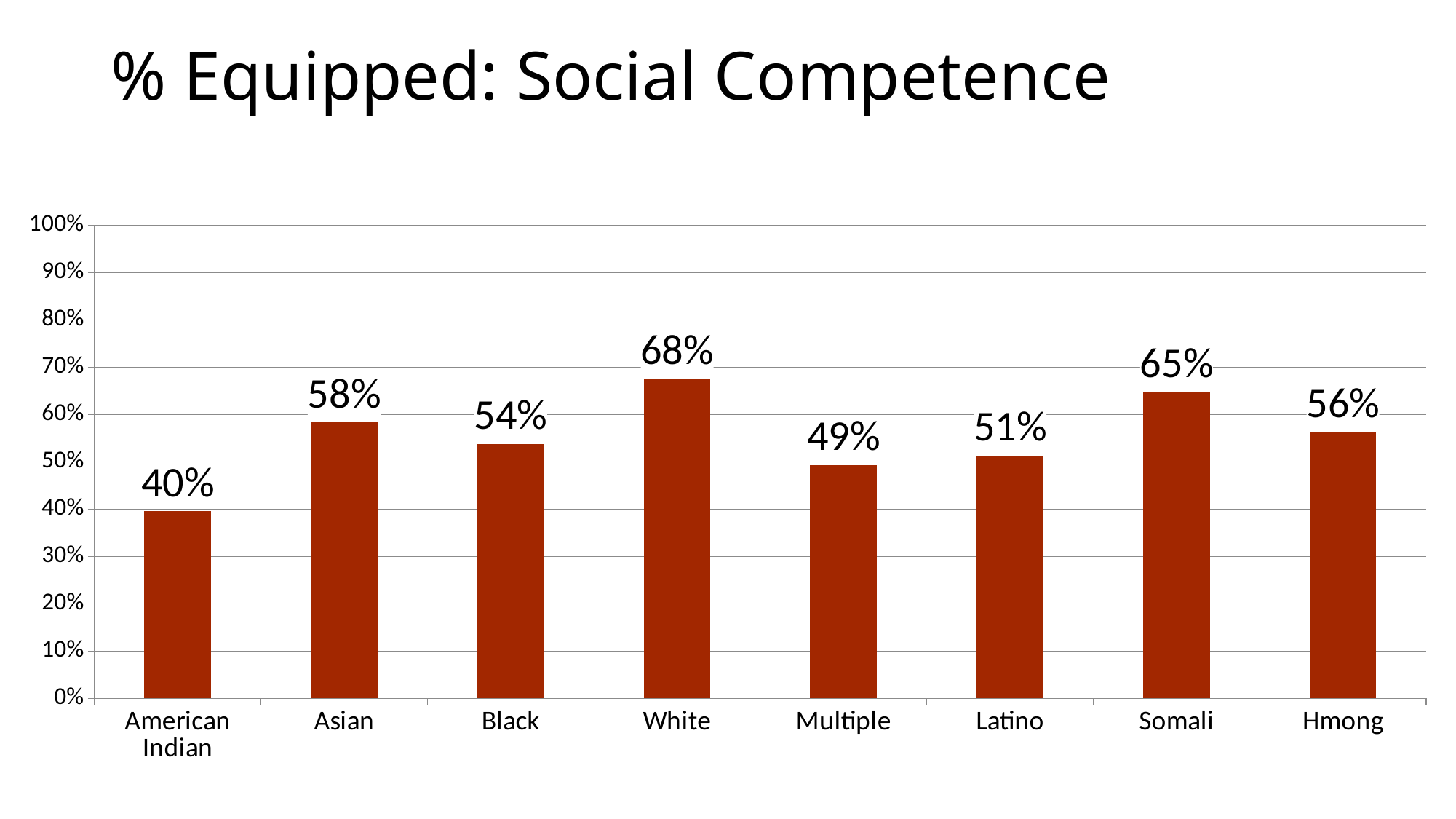
What is the value for Somali? 65% What kind of chart is shown on the slide? Bar chart What is the difference between the values for White and American Indian? 28% What is the title of the chart? % Equipped: Social Competence What is the value for Hmong? 56% What is the value for White? 68% Which category has the highest value? White Which category has the lowest value? American Indian How many categories are shown on the x axis? 8 What is the difference between the values for Asian and Black? 4% Which is larger, the value for Multiple or the value for Latino? Latino What is the value for American Indian? 40%